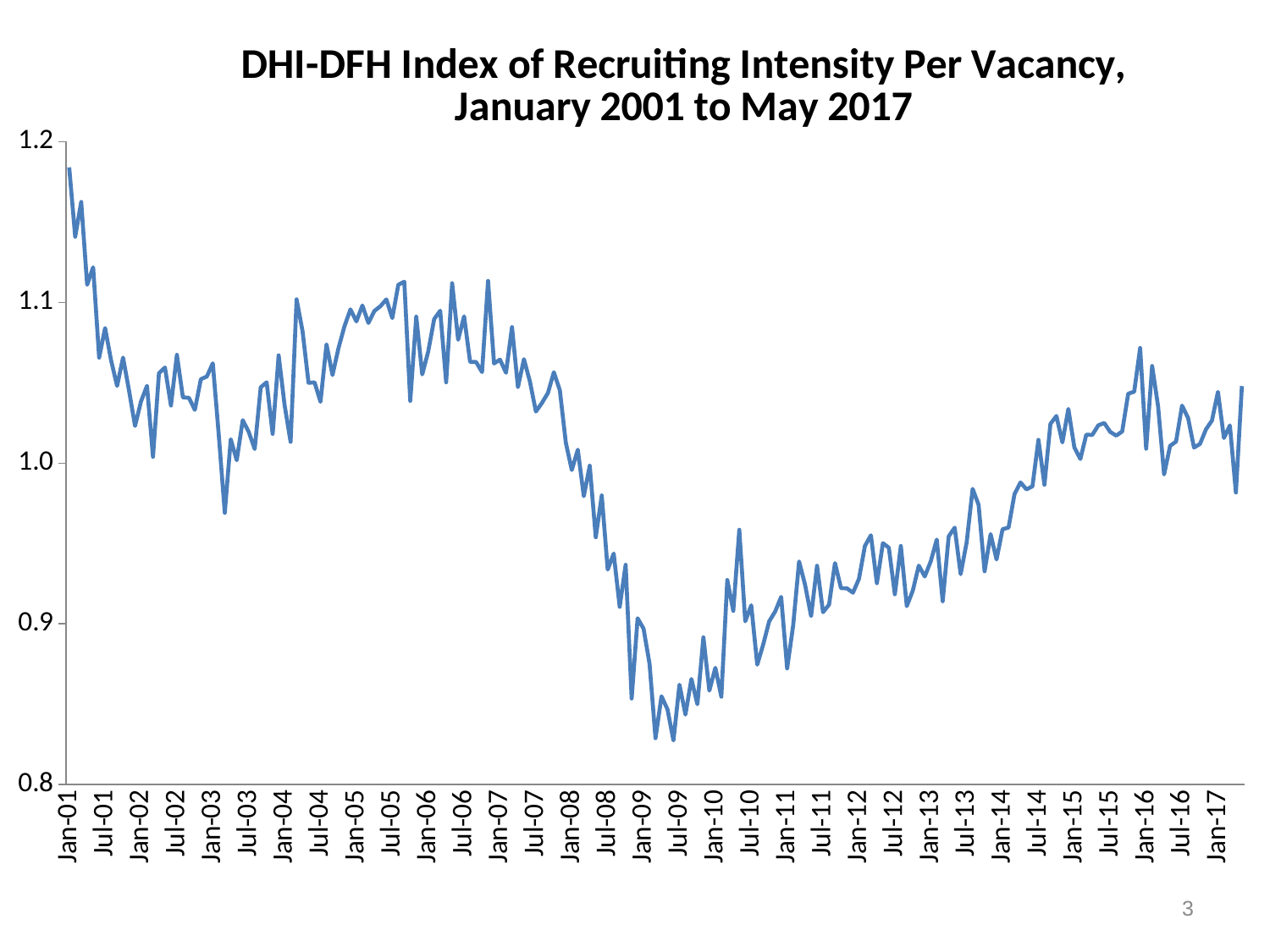
Is the value at Jan-13 greater or less than 1.0? less Is the value at Jan-05 greater or less than 1.0? greater Is the value at Jul-09 greater or less than 0.9? less What is the title of the chart? DHI-DFH Index of Recruiting Intensity Per Vacancy, January 2001 to May 2017 What is the highest value shown on the vertical axis? 1.2 At which labelled date does the line reach its highest value? Jan-01 What kind of chart is shown on the slide? line chart In which year does the line reach its lowest point? 2009 Does the index rise or fall between Jan-08 and Jan-09? fall Does the index generally rise or fall between Jan-10 and Jan-14? rise